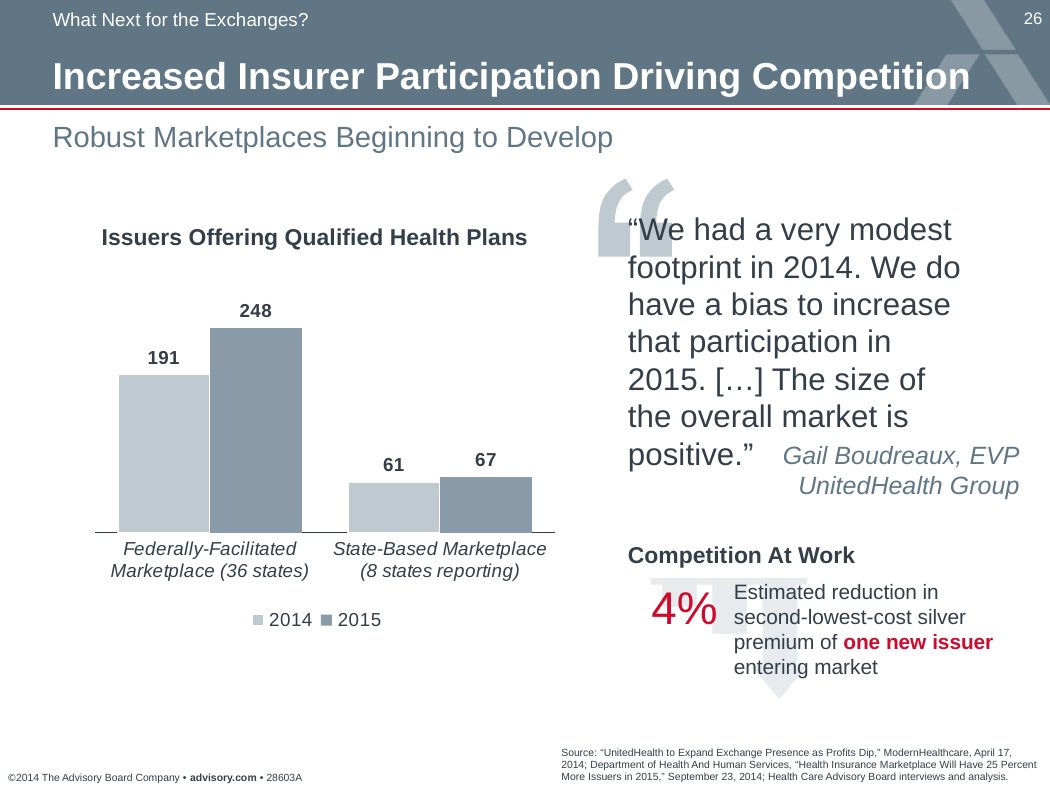
What is the 2015 value for the Federally-Facilitated Marketplace (36 states)? 248 What type of chart is shown on the slide? Bar chart How many series does the legend list? 2 What is the difference between the 2015 and 2014 values for the Federally-Facilitated Marketplace (36 states)? 57 What is the difference between the 2015 and 2014 values for the State-Based Marketplace (8 states reporting)? 6 What is the 2015 value for the State-Based Marketplace (8 states reporting)? 67 Which category has the highest 2015 value? Federally-Facilitated Marketplace (36 states) Which is larger: the 2014 value for the Federally-Facilitated Marketplace or the 2015 value for the State-Based Marketplace? 2014 value for the Federally-Facilitated Marketplace What is the 2014 value for the State-Based Marketplace (8 states reporting)? 61 What is the 2014 value for the Federally-Facilitated Marketplace (36 states)? 191 How many categories are shown on the x axis of the chart? 2 Which category has the lowest 2014 value? State-Based Marketplace (8 states reporting)